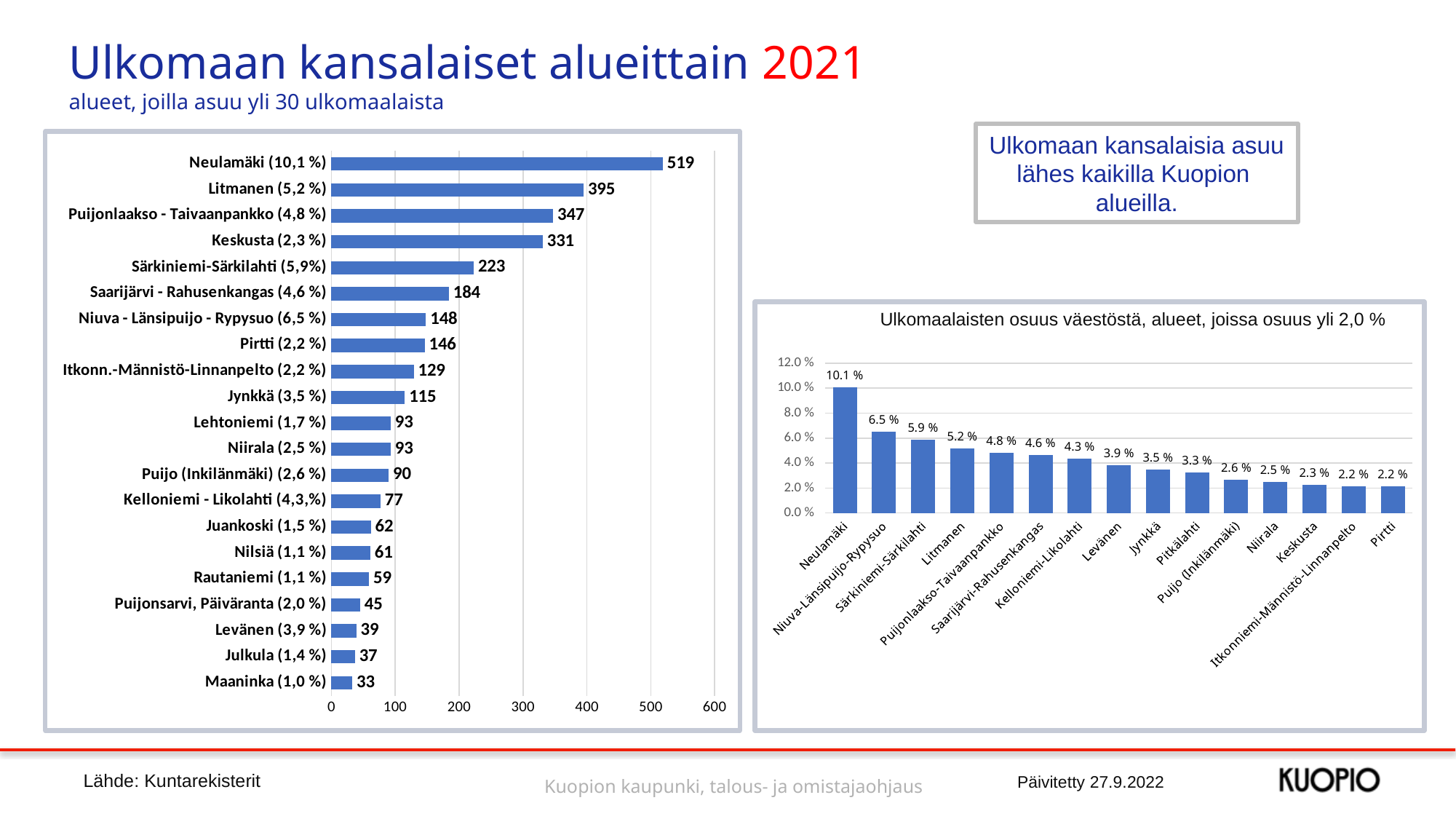
In the left chart, what is the value for Litmanen (5,2 %)? 395 How many areas are shown in the left chart? 21 In the left chart, which area has the highest value? Neulamäki (10,1 %) In the chart titled 'Ulkomaalaisten osuus väestöstä, alueet, joissa osuus yli 2,0 %', what is the difference between the values for Neulamäki and Niuva-Länsipuijo-Rypysuo? 3.6 % How many areas are shown in the chart titled 'Ulkomaalaisten osuus väestöstä, alueet, joissa osuus yli 2,0 %'? 15 In the chart titled 'Ulkomaalaisten osuus väestöstä, alueet, joissa osuus yli 2,0 %', which area has the highest share? Neulamäki In the left chart, what is the difference between the values for Neulamäki (10,1 %) and Keskusta (2,3 %)? 188 In the chart titled 'Ulkomaalaisten osuus väestöstä, alueet, joissa osuus yli 2,0 %', do the values rise or fall from left to right? Fall In the left chart, which is larger: the value for Särkiniemi-Särkilahti (5,9%) or the value for Saarijärvi - Rahusenkangas (4,6 %)? Särkiniemi-Särkilahti (5,9%) What kind of chart is the left chart? Bar chart In the chart titled 'Ulkomaalaisten osuus väestöstä, alueet, joissa osuus yli 2,0 %', what is the value for Litmanen? 5.2 % In the left chart, which area has the lowest value? Maaninka (1,0 %)